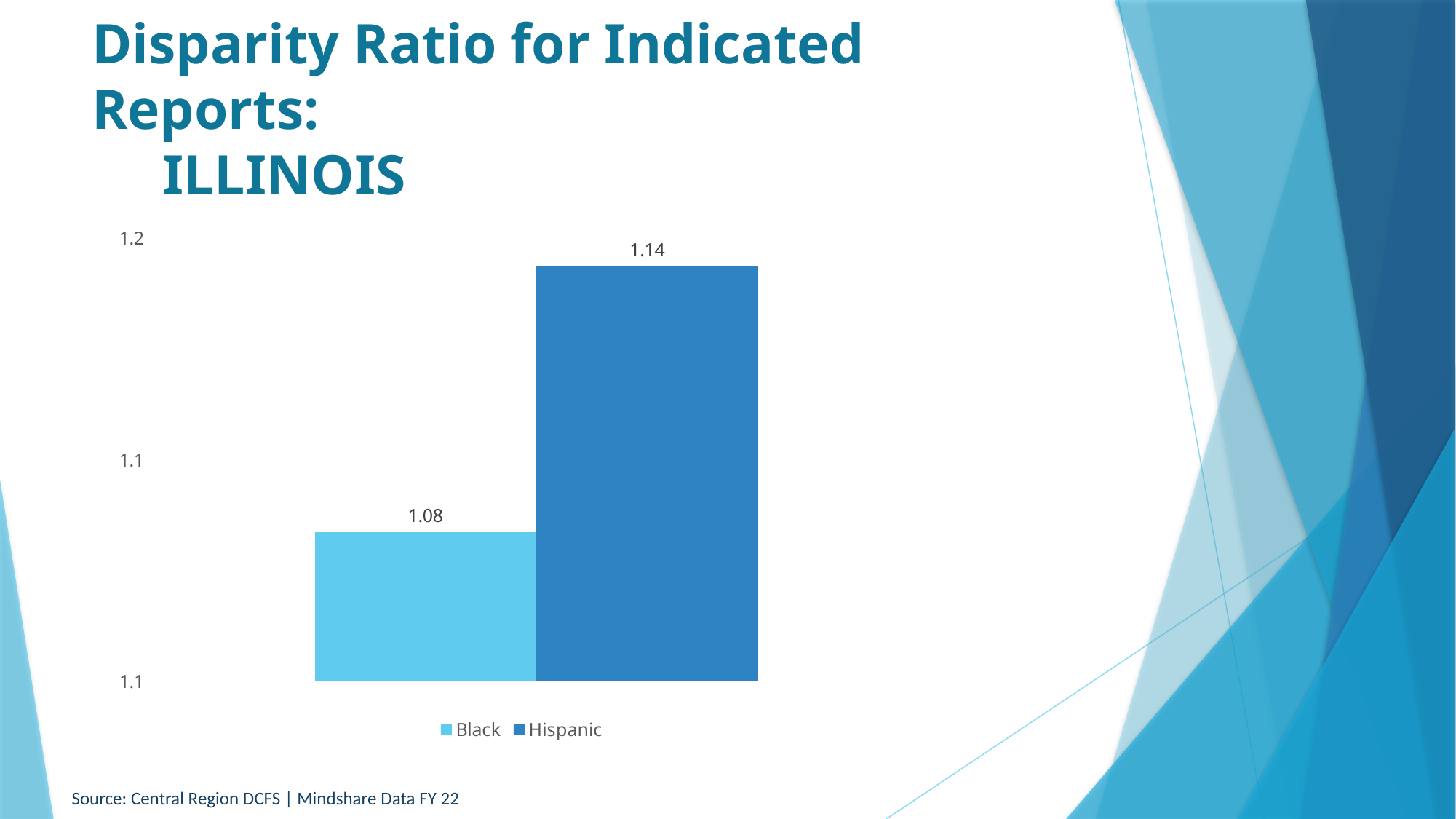
Which group has the lower disparity ratio? Black Which group has the higher disparity ratio? Hispanic How many entries does the legend list? 2 What is the title of the slide? Disparity Ratio for Indicated Reports: ILLINOIS How many bars are plotted in the chart? 2 Is the value for Hispanic greater or less than 1.1? greater What is the difference between the Hispanic and Black disparity ratios? 0.06 What is the disparity ratio for Hispanic? 1.14 What kind of chart is shown on the slide? bar chart Is the disparity ratio for Black larger or smaller than the ratio for Hispanic? smaller What is the disparity ratio for Black? 1.08 Is the value for Black greater or less than 1.1? less